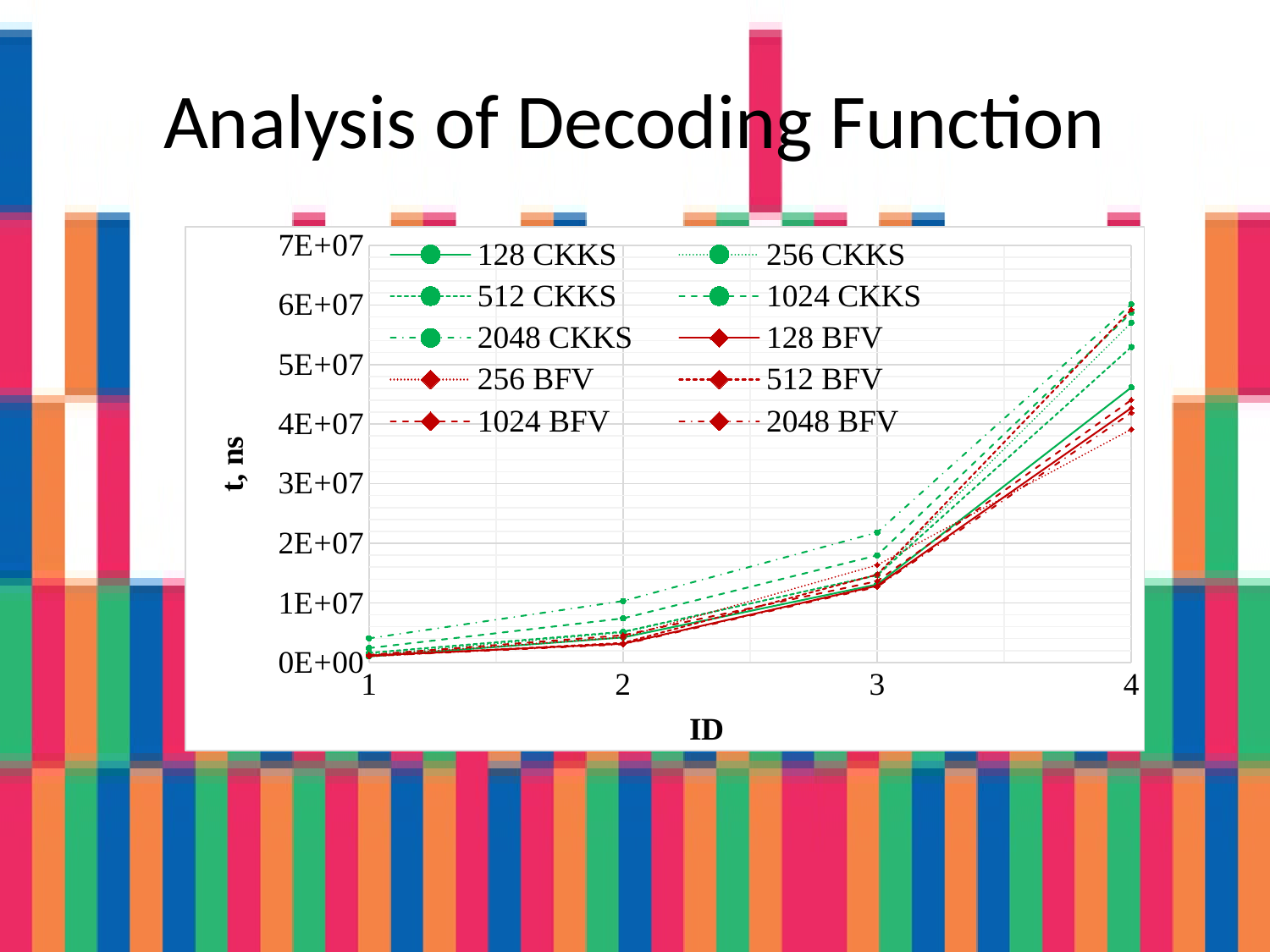
What is the title of the slide containing the chart? Analysis of Decoding Function What is the label of the y axis? t, ns How many series does the legend list? 10 Which series has the highest value at ID 3? 2048 CKKS Is the value for 2048 CKKS at ID 3 greater or less than 3E+07? less What kind of chart is shown on the slide? line chart Is the value for 2048 CKKS at ID 1 greater or less than 1E+07? less How many ID values are plotted along the x axis? 4 Do the values for 128 CKKS rise or fall as ID increases from 1 to 4? rise Is the value for 128 CKKS at ID 4 greater or less than 4E+07? greater Which series has the highest value at ID 2? 2048 CKKS